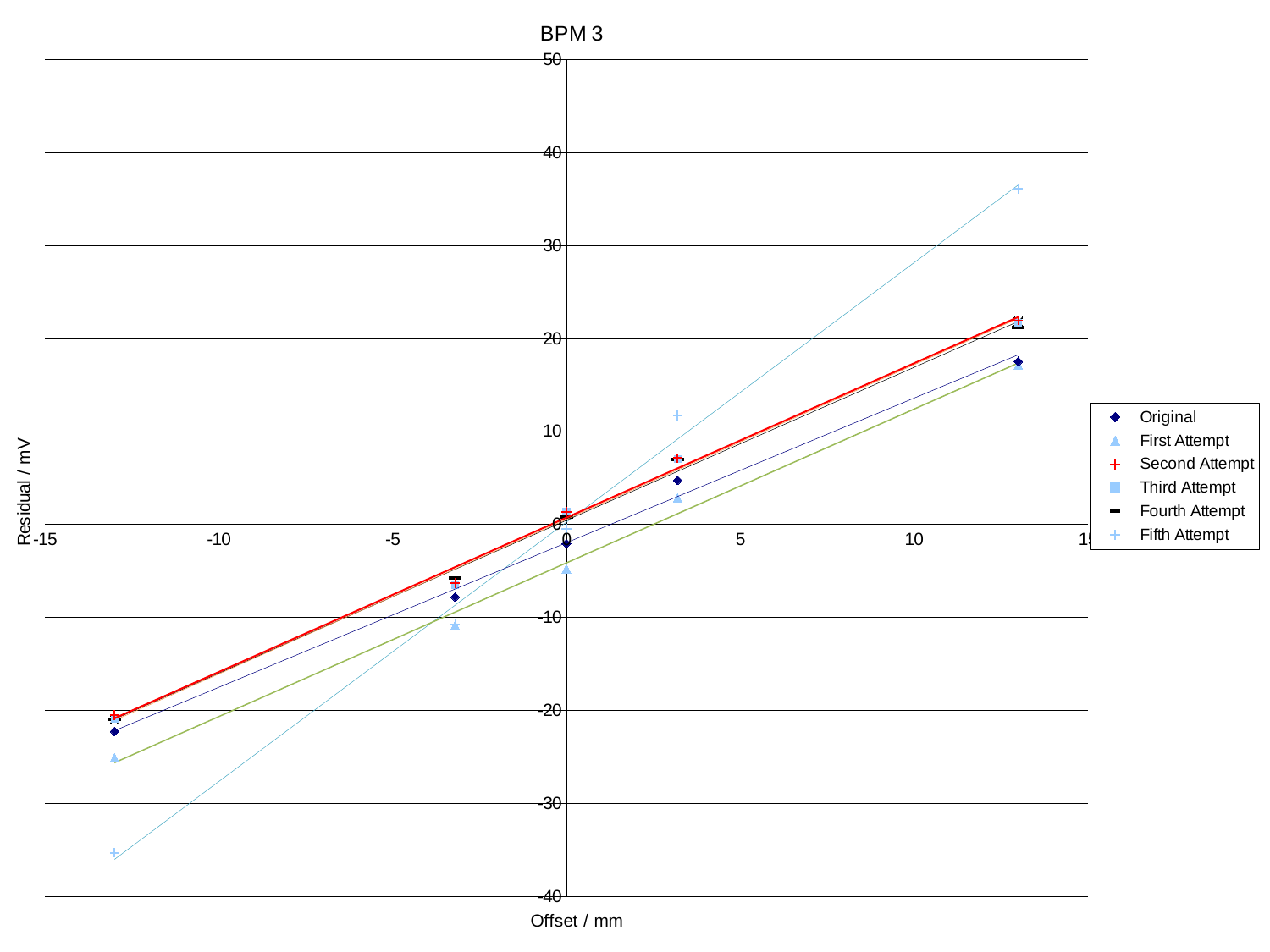
How many series does the legend list? 6 Do the values for each series rise or fall as the offset increases along the x axis? Rise Is the Fifth Attempt value at the largest positive offset (around 13 mm) greater or less than 30? greater Is the Original value at the largest positive offset (around 13 mm) greater or less than 20? less What is the title of the chart? BPM 3 Which series reaches the highest residual value on the chart? Fifth Attempt What kind of chart is shown on the slide? Scatter chart How many data points are plotted for each series? 5 What is the label of the y axis? Residual / mV Is the Fifth Attempt value at the largest negative offset (around -13 mm) greater or less than -30? less At the largest positive offset (around 13 mm), which series has the larger value: Fifth Attempt or Original? Fifth Attempt